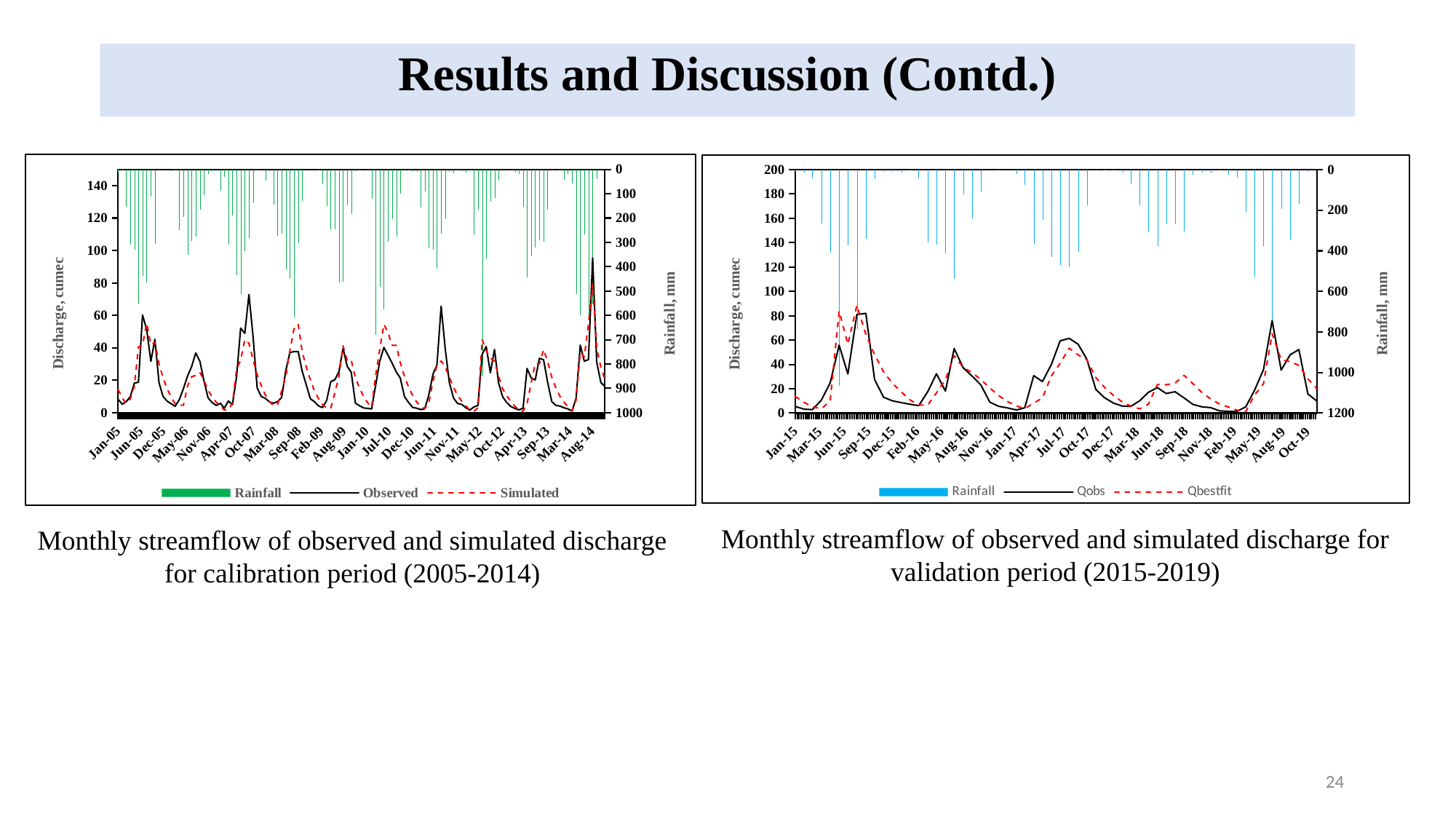
In the right chart (validation period), what is the maximum value shown on the left discharge axis? 200 In the left chart (calibration period), is the observed discharge peak around Oct-07 greater or less than 60 cumec? greater In the left chart (calibration period), what is the label of the left vertical axis? Discharge, cumec In the right chart (validation period), what is the label of the right vertical axis? Rainfall, mm In the left chart (calibration period), how many series does the legend list? 3 What kind of chart is used for the observed and simulated discharge series in both charts? Line chart In the left chart (calibration period), is the highest observed discharge peak (around Aug-14) greater or less than 80 cumec? greater In the right chart (validation period), is the observed discharge peak around Sep-15 greater or less than 100 cumec? less